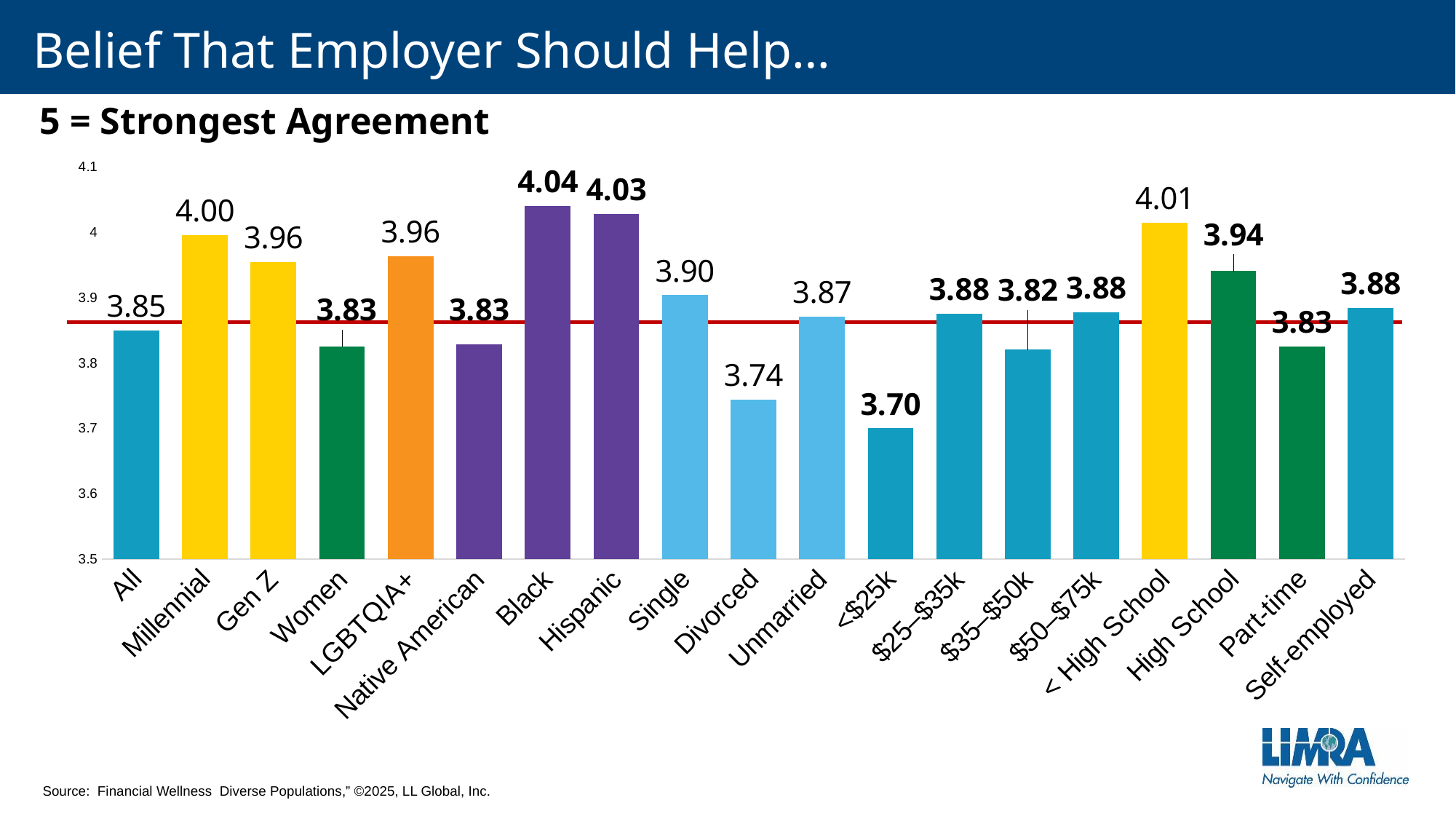
How many categories are shown on the x axis? 19 What is the difference between the values for Millennial and Women? 0.17 Which category has the highest value? Black What is the title of the slide? Belief That Employer Should Help… Is the value for Hispanic greater or less than 4? greater What is the value for < High School? 4.01 Which is larger, the value for Single or the value for Unmarried? Single Which category has the lowest value? <$25k What is the value for Black? 4.04 What is the value for Divorced? 3.74 What is the value for All? 3.85 What kind of chart is this? bar chart